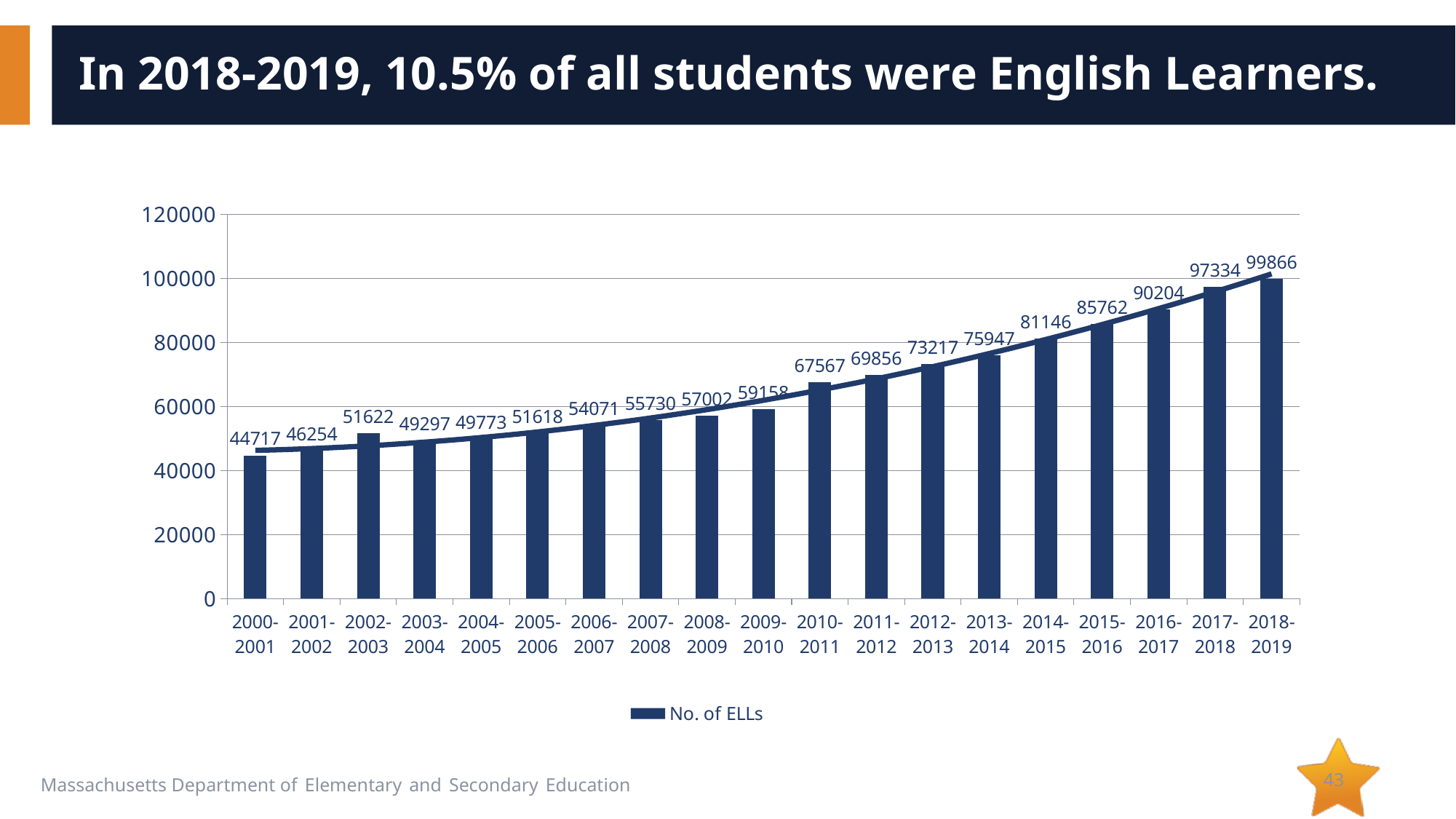
What is the difference in the number of ELLs between 2017-2018 and 2016-2017? 7130 What kind of chart is shown on the slide? Bar chart What is the number of ELLs for 2010-2011? 67567 What is the number of ELLs for 2000-2001? 44717 What is the legend entry for the bars? No. of ELLs Which school year has the highest number of ELLs? 2018-2019 Which year has more ELLs, 2002-2003 or 2003-2004? 2002-2003 What is the difference in the number of ELLs between 2018-2019 and 2000-2001? 55149 Is the number of ELLs for 2014-2015 greater or less than 80000? greater What is the number of ELLs for 2018-2019? 99866 How many school years are shown on the x axis? 19 Which school year has the lowest number of ELLs? 2000-2001